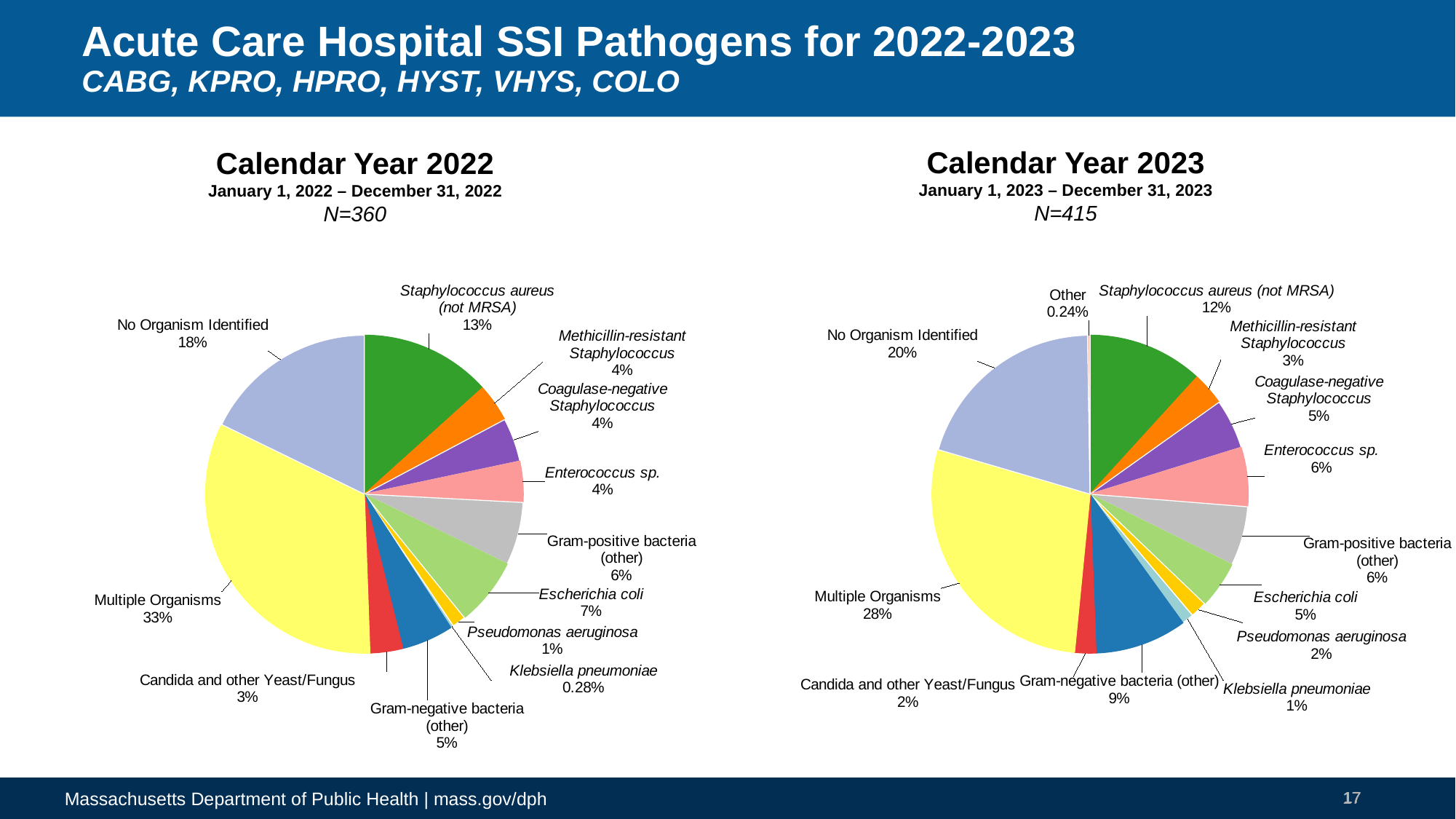
In the Calendar Year 2023 chart, which category has the smallest slice? Other In the Calendar Year 2023 chart, what is the value for Gram-negative bacteria (other)? 9% In the Calendar Year 2022 chart, what is the value for Pseudomonas aeruginosa? 1% In the Calendar Year 2023 chart, what share of the pie is No Organism Identified? 20% In the Calendar Year 2022 chart, which category has the largest slice? Multiple Organisms In the Calendar Year 2022 chart, what share of the pie is Multiple Organisms? 33% In the Calendar Year 2022 chart, what is the difference between Staphylococcus aureus (not MRSA) and Escherichia coli? 6% What is the N value shown for the Calendar Year 2023 chart? N=415 How many slices does the Calendar Year 2023 pie chart have? 13 In the Calendar Year 2023 chart, which is larger: Enterococcus sp. or Coagulase-negative Staphylococcus? Enterococcus sp. What kind of chart is used for Calendar Year 2022? Pie chart In the Calendar Year 2022 chart, what is the value for Klebsiella pneumoniae? 0.28%